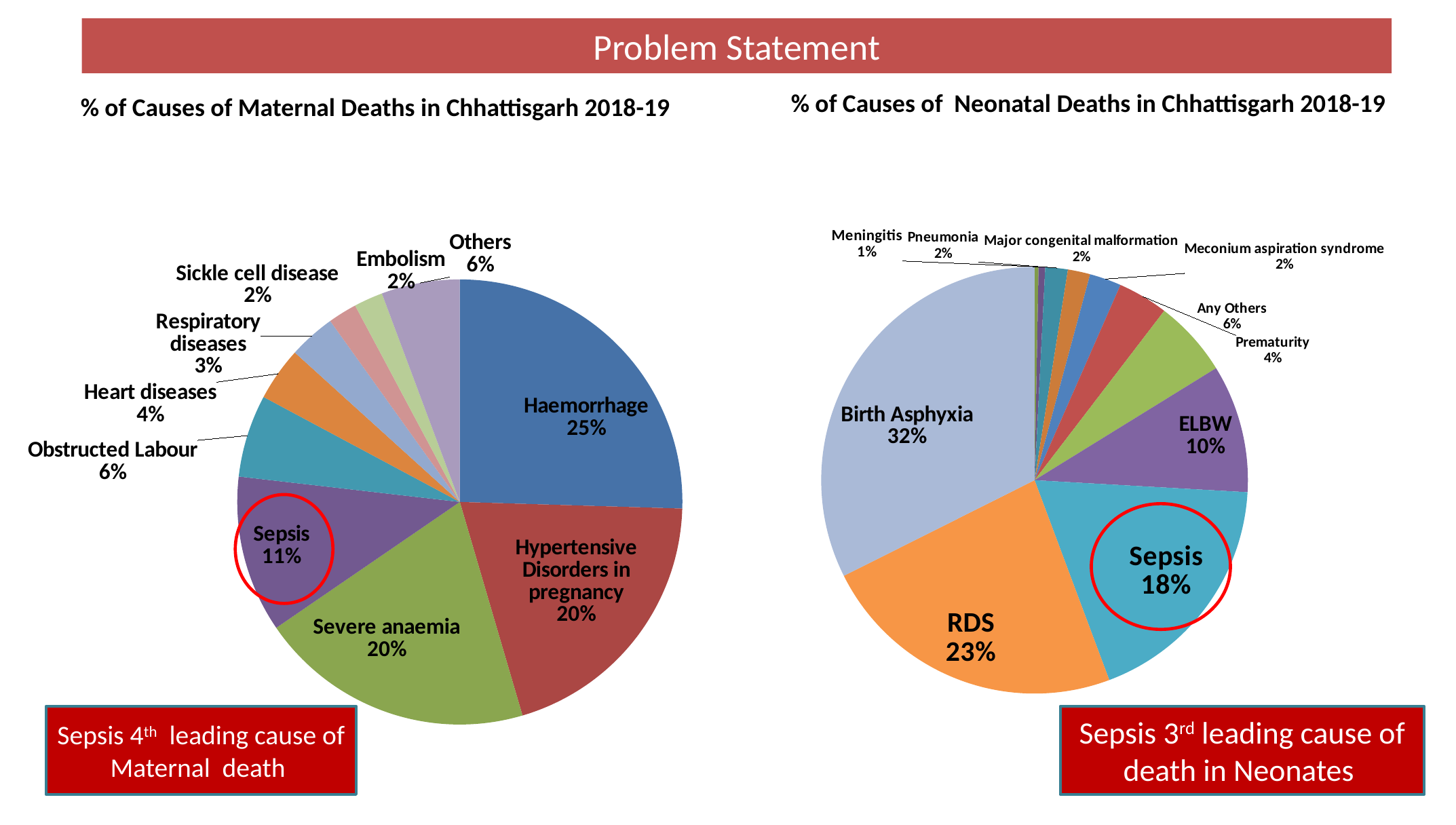
In the '% of Causes of Neonatal Deaths in Chhattisgarh 2018-19' chart, what share is Birth Asphyxia? 32% In the '% of Causes of Maternal Deaths in Chhattisgarh 2018-19' chart, what share is Sepsis? 11% In the '% of Causes of Neonatal Deaths in Chhattisgarh 2018-19' chart, which cause has the smallest share? Meningitis In the '% of Causes of Maternal Deaths in Chhattisgarh 2018-19' chart, what is the difference between the Haemorrhage share and the Sepsis share? 14% What type of chart is used for the '% of Causes of Neonatal Deaths in Chhattisgarh 2018-19'? Pie chart In the '% of Causes of Maternal Deaths in Chhattisgarh 2018-19' chart, what share is Obstructed Labour? 6% In the '% of Causes of Neonatal Deaths in Chhattisgarh 2018-19' chart, what is the difference between the RDS share and the Sepsis share? 5% In the '% of Causes of Maternal Deaths in Chhattisgarh 2018-19' chart, which is larger: Heart diseases or Respiratory diseases? Heart diseases In the '% of Causes of Neonatal Deaths in Chhattisgarh 2018-19' chart, what share is ELBW? 10% In the '% of Causes of Neonatal Deaths in Chhattisgarh 2018-19' chart, which is larger: Prematurity or Any Others? Any Others In the '% of Causes of Maternal Deaths in Chhattisgarh 2018-19' chart, how many causes are shown in the pie? 10 In the '% of Causes of Maternal Deaths in Chhattisgarh 2018-19' chart, which cause has the largest share? Haemorrhage